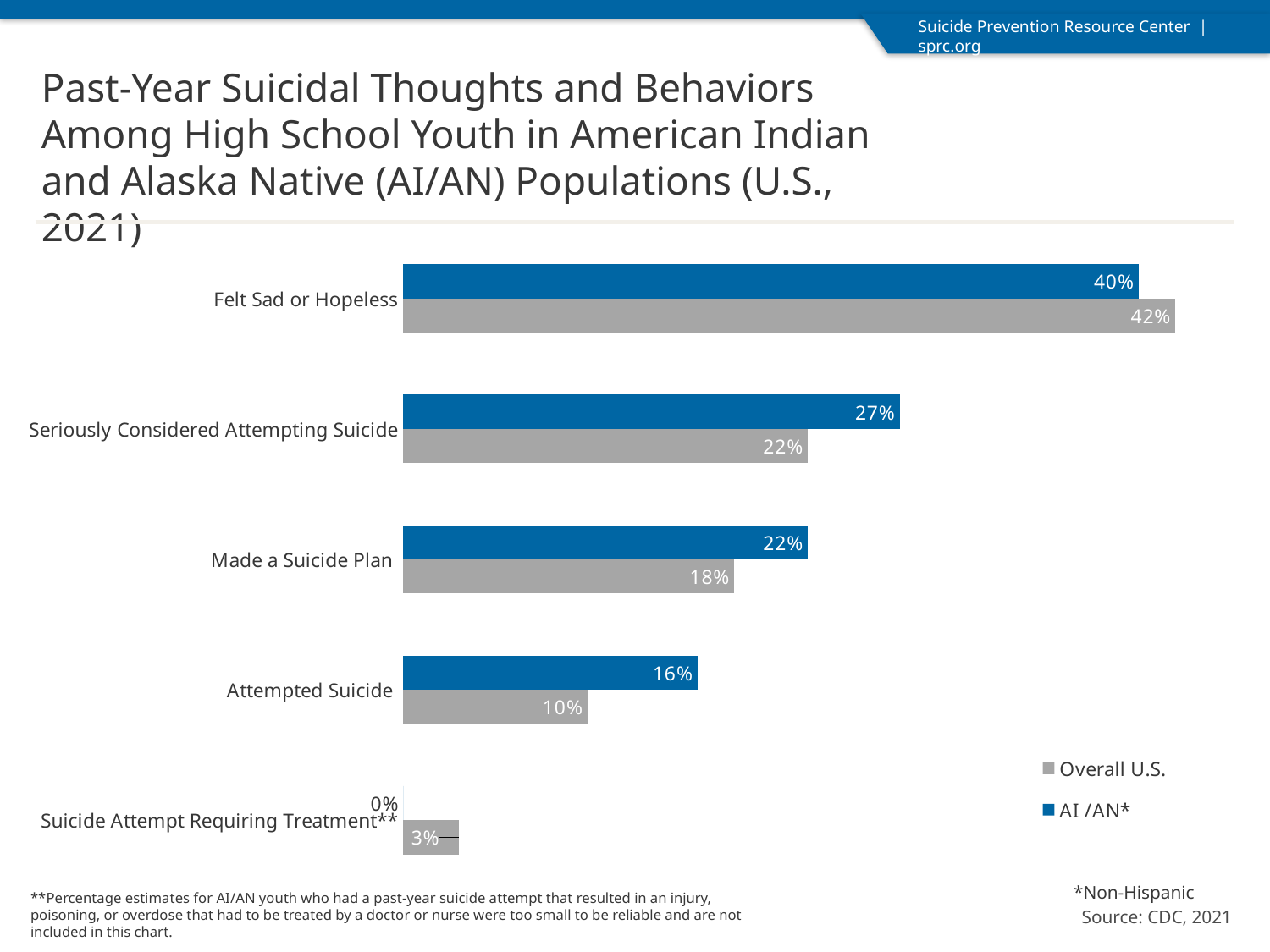
Which colour represents the Overall U.S. series? Gray What is the difference between the AI/AN* and Overall U.S. values for Attempted Suicide? 6% Which category has the highest Overall U.S. value? Felt Sad or Hopeless What kind of chart is shown on the slide? Bar chart Which category has the lowest AI/AN* value? Suicide Attempt Requiring Treatment** How many categories are shown on the chart? 5 Which is larger for Made a Suicide Plan: the AI/AN* value or the Overall U.S. value? AI/AN* What is the difference between the Overall U.S. and AI/AN* values for Felt Sad or Hopeless? 2% What is the Overall U.S. value for Seriously Considered Attempting Suicide? 22% What is the Overall U.S. value for Attempted Suicide? 10% What is the AI/AN* value for Felt Sad or Hopeless? 40% How many series does the legend list? 2